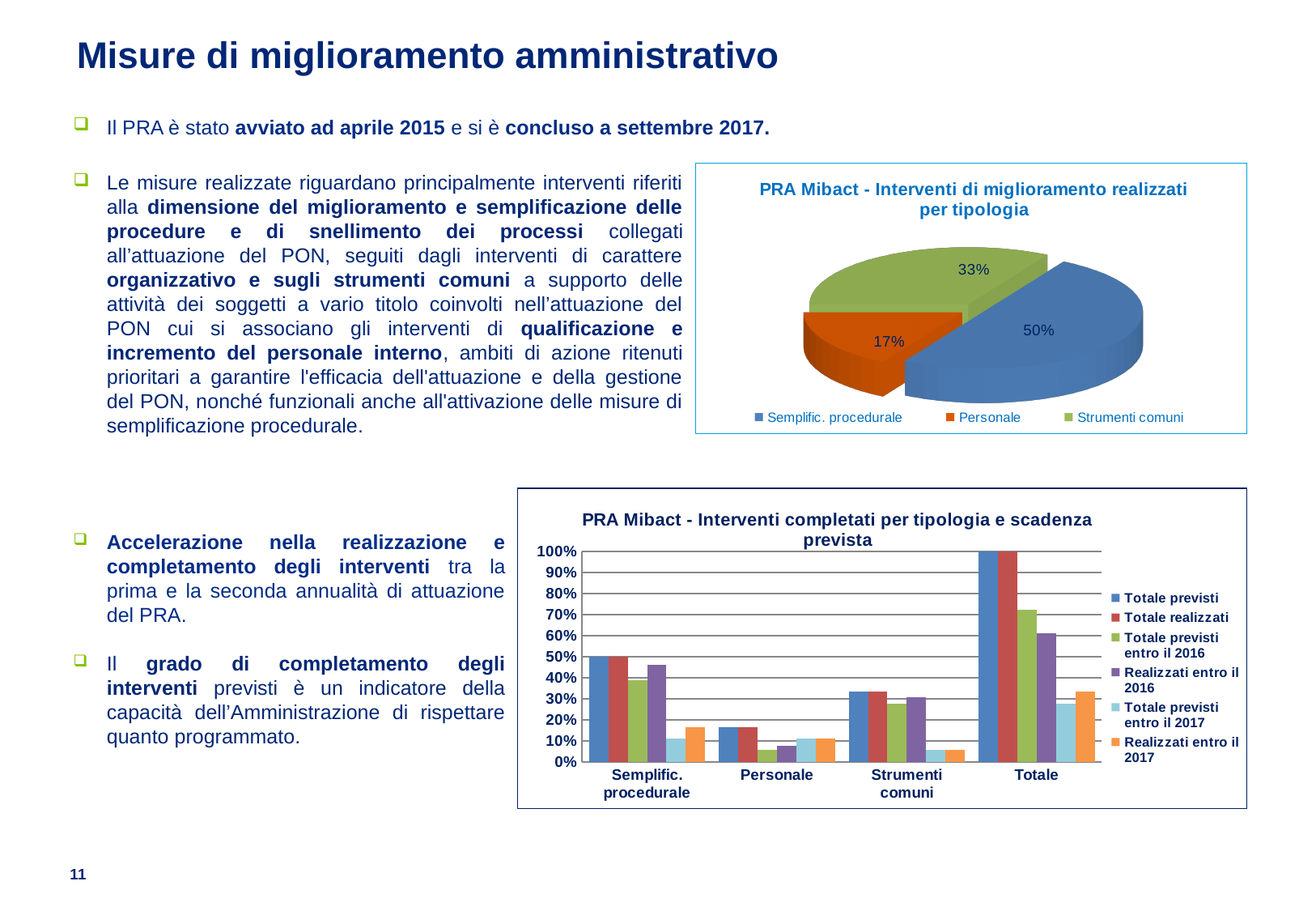
What kind of chart is 'PRA Mibact - Interventi completati per tipologia e scadenza prevista'? Bar chart In the chart 'PRA Mibact - Interventi completati per tipologia e scadenza prevista', what is the value of Totale previsti for the Totale category? 100% How many series does the legend of the chart 'PRA Mibact - Interventi completati per tipologia e scadenza prevista' list? 6 How many categories are shown on the x axis of the chart 'PRA Mibact - Interventi completati per tipologia e scadenza prevista'? 4 In the chart 'PRA Mibact - Interventi completati per tipologia e scadenza prevista', is the value of Realizzati entro il 2017 for Strumenti comuni greater or less than 10%? less In the pie chart 'PRA Mibact - Interventi di miglioramento realizzati per tipologia', what share is Semplific. procedurale? 50% In the chart 'PRA Mibact - Interventi completati per tipologia e scadenza prevista', is the value of Totale previsti entro il 2016 for Totale greater or less than 60%? greater How many slices does the pie chart 'PRA Mibact - Interventi di miglioramento realizzati per tipologia' have? 3 In the pie chart 'PRA Mibact - Interventi di miglioramento realizzati per tipologia', which category has the largest slice? Semplific. procedurale In the pie chart 'PRA Mibact - Interventi di miglioramento realizzati per tipologia', which category has the smallest slice? Personale In the pie chart 'PRA Mibact - Interventi di miglioramento realizzati per tipologia', how many percentage points larger is Strumenti comuni than Personale? 16% In the pie chart 'PRA Mibact - Interventi di miglioramento realizzati per tipologia', what share is Personale? 17%